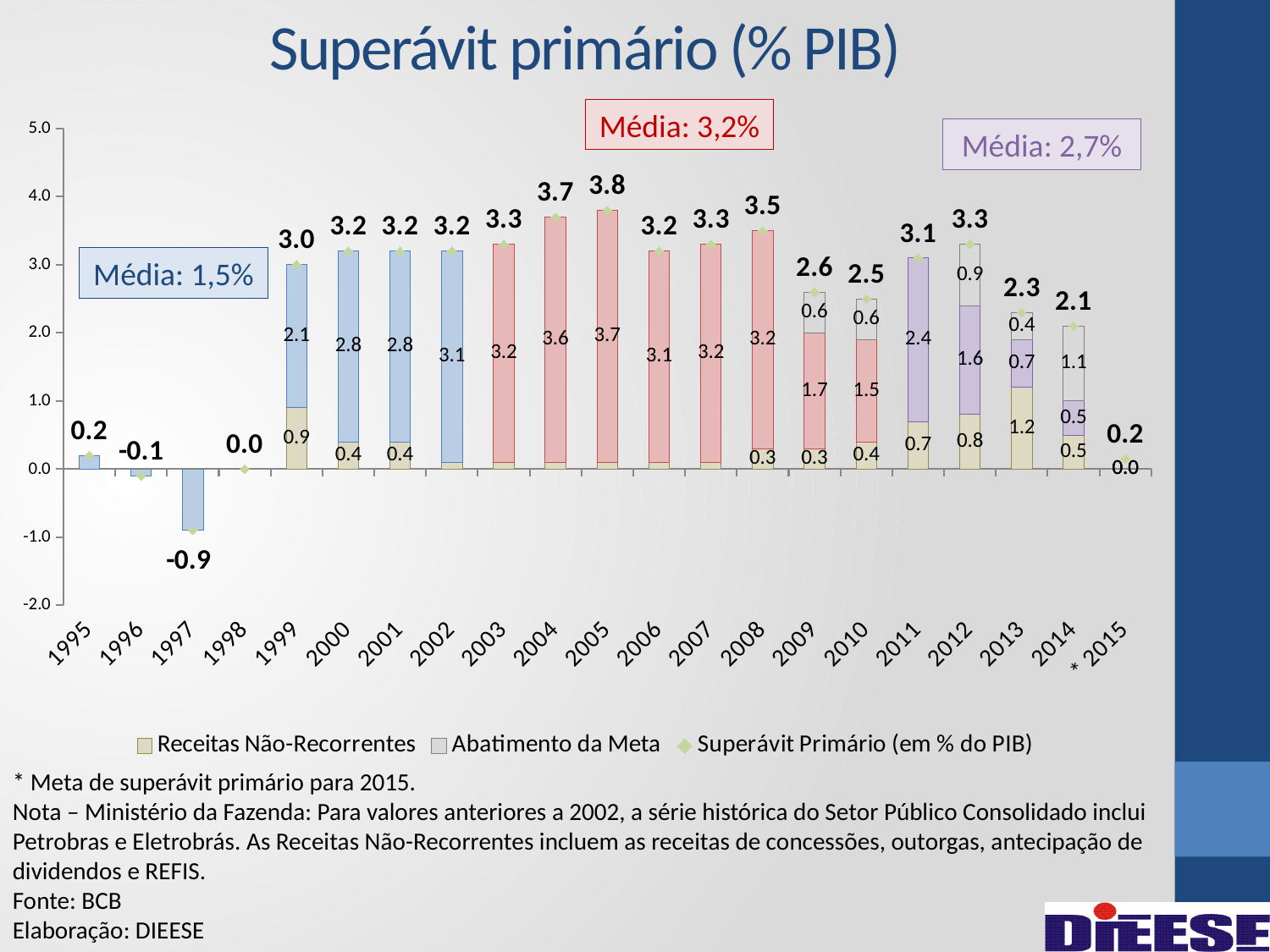
What kind of chart is shown on the slide? bar chart What is the Superávit Primário (em % do PIB) value for 1997? -0.9 How many series does the legend list? 3 What is the Superávit Primário (em % do PIB) value for 2005? 3.8 What is the difference between the Superávit Primário values for 2005 and 2014? 1.7 How many years are shown on the x axis? 21 Which year has the lowest Superávit Primário (em % do PIB) value? 1997 What is the Abatimento da Meta value for 2012? 0.9 Do the Superávit Primário values rise or fall from 2012 to 2014? fall Which year has a larger Superávit Primário value, 2011 or 2013? 2011 What is the Receitas Não-Recorrentes value for 2013? 1.2 Which year has the highest Superávit Primário (em % do PIB) value? 2005